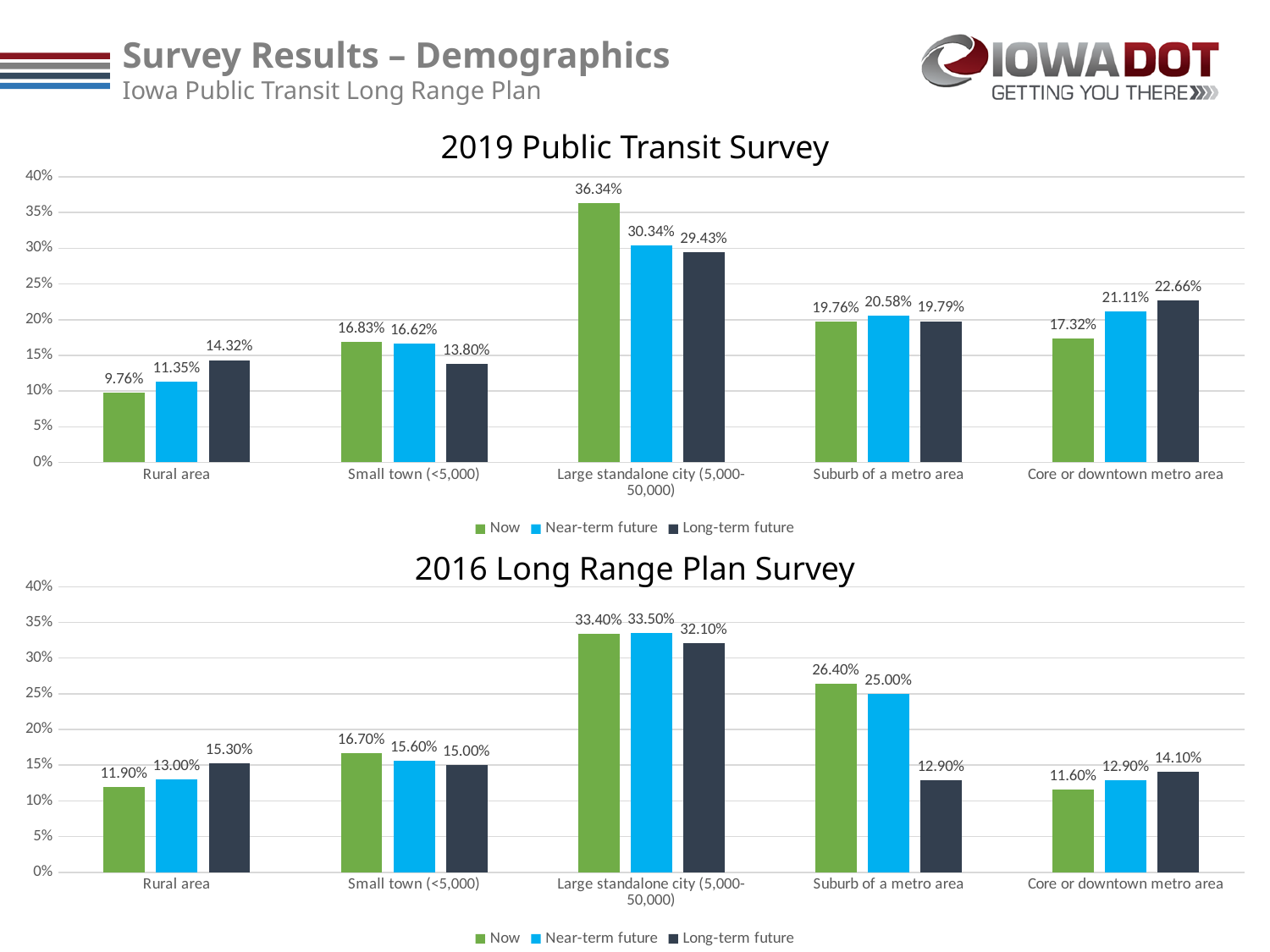
What kind of chart is the 2019 Public Transit Survey chart? Bar chart How many categories are shown on the x axis of the 2016 Long Range Plan Survey chart? 5 In the 2019 Public Transit Survey chart, which category has the lowest Near-term future value? Rural area In the 2016 Long Range Plan Survey chart, what is the difference between the Now and Long-term future values for Suburb of a metro area? 13.50% In the 2019 Public Transit Survey chart, what is the value for Now in the Rural area category? 9.76% In the 2019 Public Transit Survey chart, what is the Long-term future value for Core or downtown metro area? 22.66% In the 2019 Public Transit Survey chart, what is the difference between the Now and Long-term future values for Large standalone city (5,000-50,000)? 6.91% In the 2016 Long Range Plan Survey chart, what is the Now value for Core or downtown metro area? 11.60% In the 2016 Long Range Plan Survey chart, which is larger for Suburb of a metro area: the Now value or the Long-term future value? Now How many series does the legend of the 2019 Public Transit Survey chart list? 3 In the 2016 Long Range Plan Survey chart, what is the Near-term future value for Suburb of a metro area? 25.00% In the 2019 Public Transit Survey chart, which category has the highest Now value? Large standalone city (5,000-50,000)